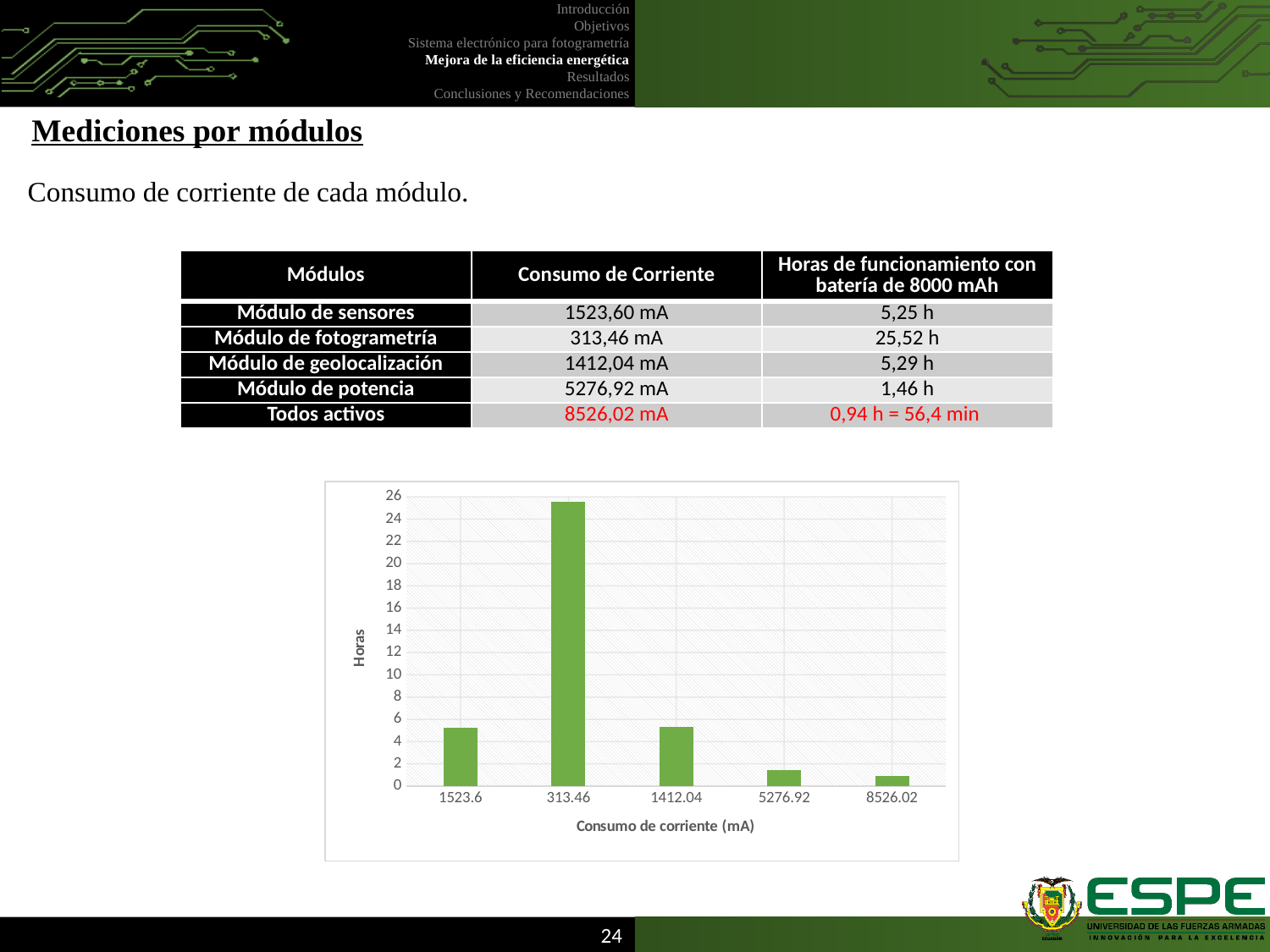
What kind of chart is shown on the slide? bar chart Is the value for 313.46 greater or less than 24? greater What is the label of the x axis? Consumo de corriente (mA) Is the value for 1523.6 greater or less than 6? less How many bars does the chart have? 5 Which has a larger value, 1523.6 or 8526.02? 1523.6 What is the label of the y axis? Horas Is the value for 1412.04 greater or less than 4? greater Which has a larger value, 313.46 or 5276.92? 313.46 Which category on the x axis has the shortest bar? 8526.02 Which category on the x axis has the tallest bar? 313.46